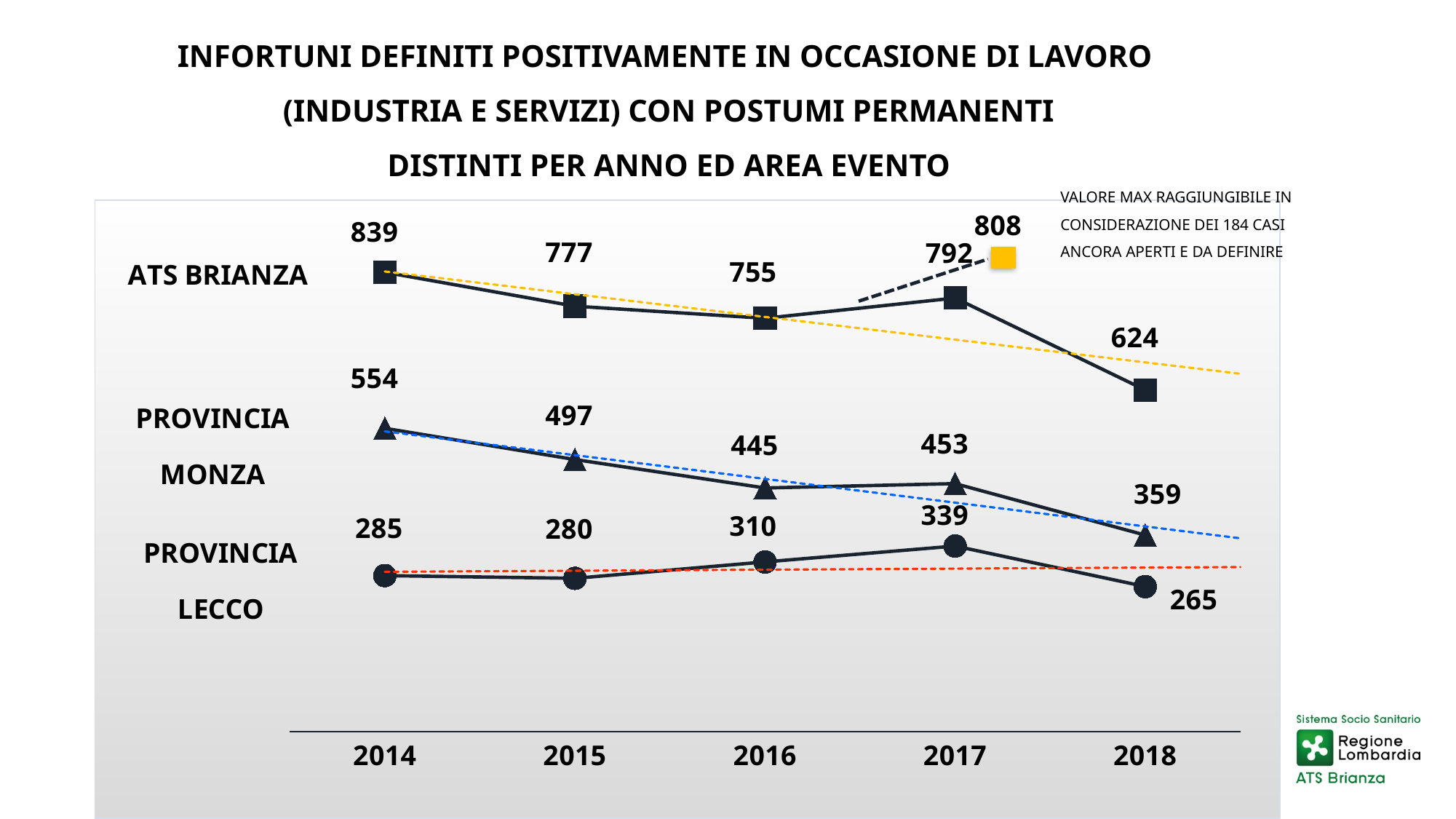
What kind of chart is shown on the slide? line chart What is the difference between the ATS BRIANZA values in 2017 and 2018? 168 What is the value for PROVINCIA MONZA in 2016? 445 Does the PROVINCIA MONZA series generally rise or fall from 2014 to 2018? fall What is the value for ATS BRIANZA in 2014? 839 In which year is the PROVINCIA LECCO value highest? 2017 How many years are shown on the x axis? 5 What is the value for PROVINCIA LECCO in 2018? 265 In which year is the ATS BRIANZA value lowest? 2018 Which is larger, the PROVINCIA LECCO value in 2016 or in 2015? 2016 How many data series are plotted in the chart? 3 What is the difference between the PROVINCIA MONZA values in 2014 and 2015? 57